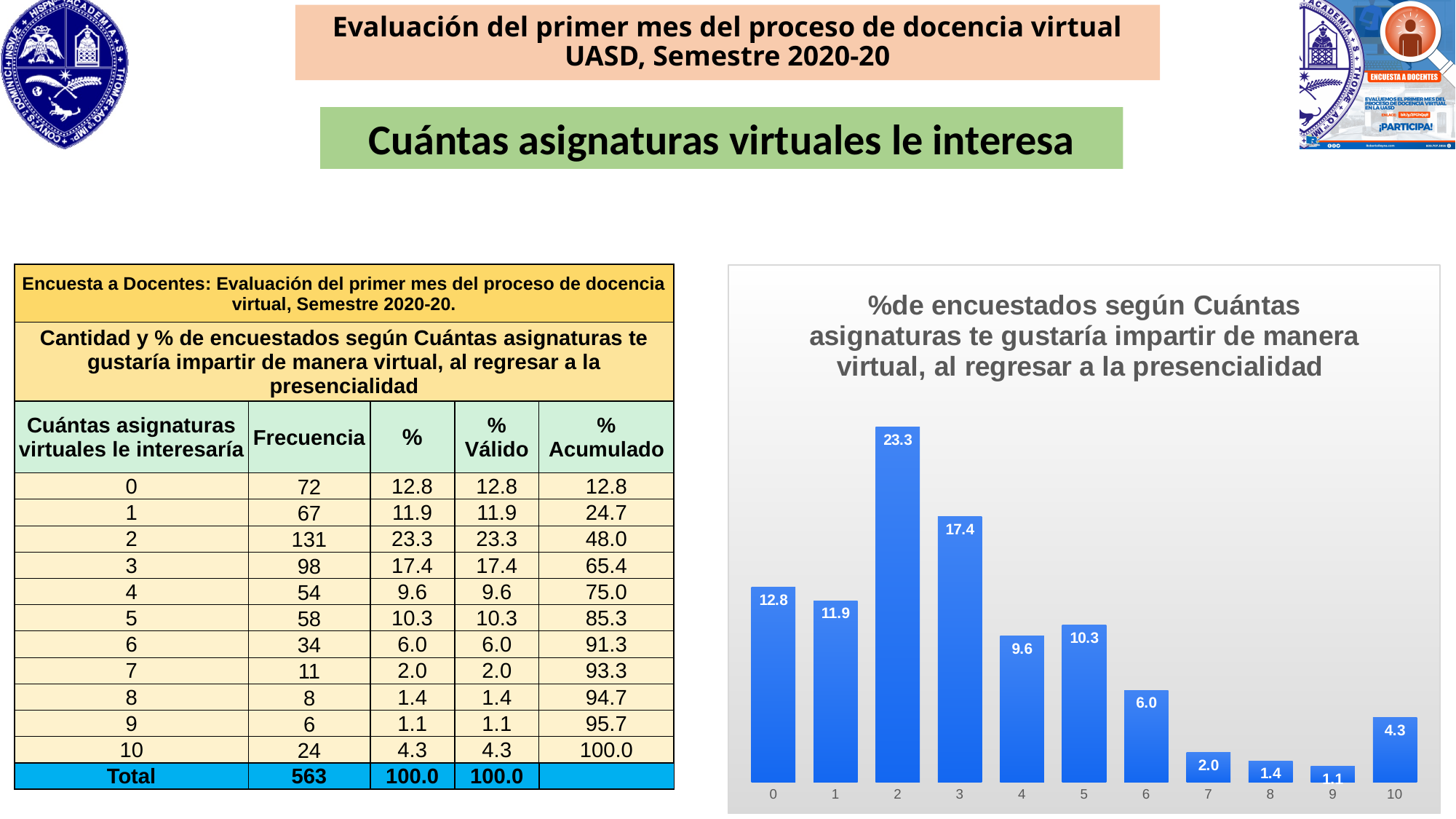
What is the difference between the values for category 0 and category 1 in the bar chart? 0.9 What kind of chart is shown on the right of the slide? bar chart What is the value for category 10 in the bar chart? 4.3 What is the value for category 5 in the bar chart? 10.3 Which category has the highest value in the bar chart? 2 What is the value for category 2 in the bar chart? 23.3 How many categories are shown on the x axis of the bar chart? 11 Which category has the lowest value in the bar chart? 9 Which is larger in the bar chart, the value for category 4 or category 5? 5 Do the values in the bar chart rise or fall from category 3 to category 9? fall What is the title of the bar chart? %de encuestados según Cuántas asignaturas te gustaría impartir de manera virtual, al regresar a la presencialidad What is the difference between the values for category 2 and category 3 in the bar chart? 5.9